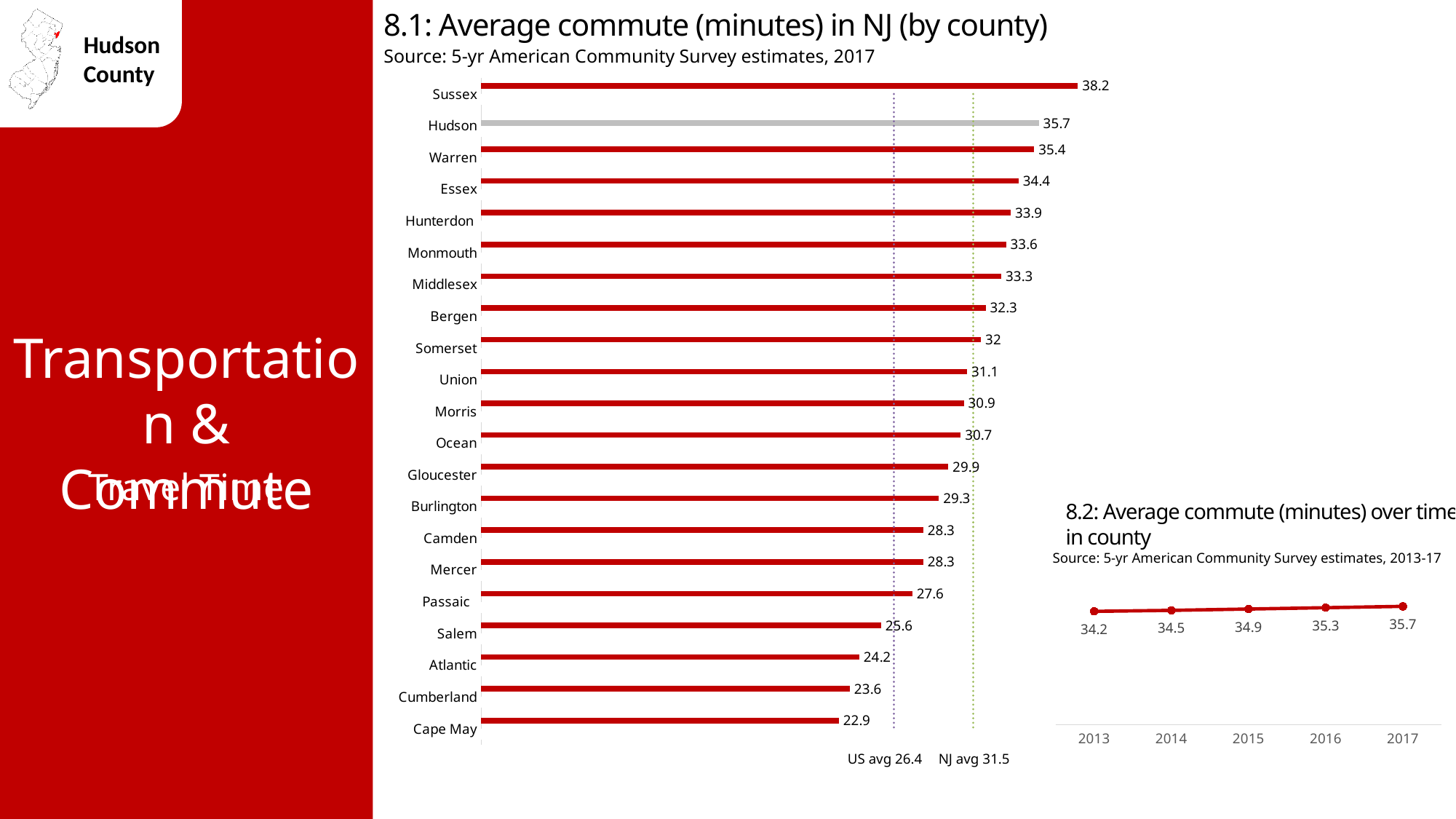
In chart 8.1 (Average commute in NJ by county), what is the average commute for Passaic? 27.6 In chart 8.1 (Average commute in NJ by county), what is the average commute for Hudson? 35.7 In chart 8.1 (Average commute in NJ by county), which has a higher average commute, Bergen or Somerset? Bergen In chart 8.1 (Average commute in NJ by county), what is the difference between the values for Sussex and Hudson? 2.5 In chart 8.2 (Average commute over time in county), what was the average commute in 2013? 34.2 In chart 8.2 (Average commute over time in county), do the values rise or fall from 2013 to 2017? Rise In chart 8.1 (Average commute in NJ by county), what NJ average value is marked by the dotted reference line? 31.5 In chart 8.2 (Average commute over time in county), what is the difference between the 2017 and 2013 values? 1.5 In chart 8.1 (Average commute in NJ by county), which county has the highest average commute? Sussex What kind of chart is chart 8.1 (Average commute in NJ by county)? Bar chart In chart 8.1 (Average commute in NJ by county), how many counties are shown? 21 In chart 8.1 (Average commute in NJ by county), which county has the lowest average commute? Cape May